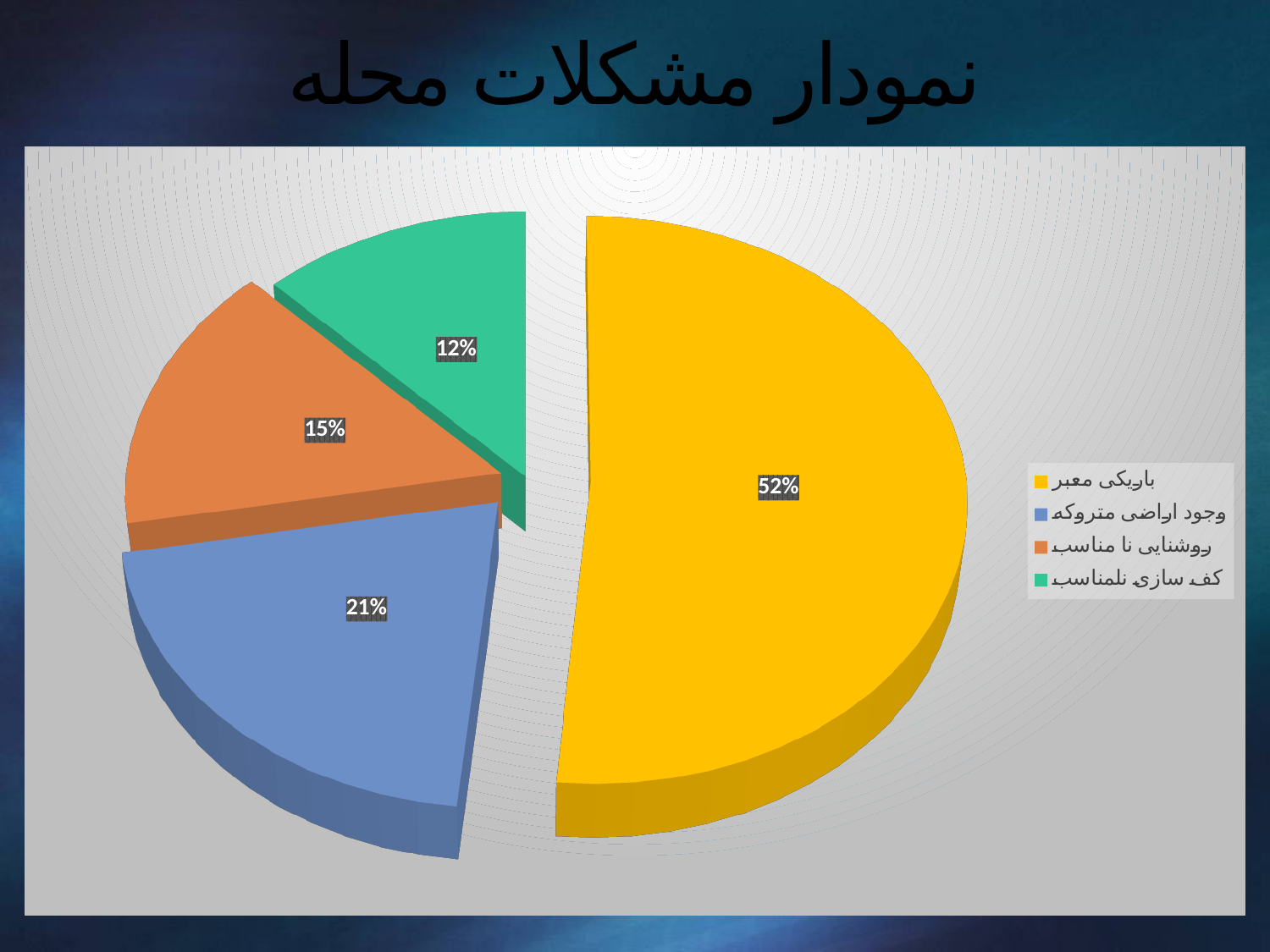
Which category has the largest share of the pie? باریکی معبر What is the difference in percentage points between باریکی معبر and وجود اراضی متروکه? 31 What is the title of the chart? نمودار مشکلات محله Which category has the smallest share of the pie? کف سازی نامناسب What percentage is shown for کف سازی نامناسب? 12% Which is larger, the share for روشنایی نا مناسب or the share for کف سازی نامناسب? روشنایی نا مناسب How many slices does the pie chart have? 4 What kind of chart is shown on the slide? Pie chart What percentage is shown for روشنایی نا مناسب? 15% What percentage is shown for وجود اراضی متروکه? 21% What colour is the slice for وجود اراضی متروکه? Blue What percentage is shown for باریکی معبر? 52%